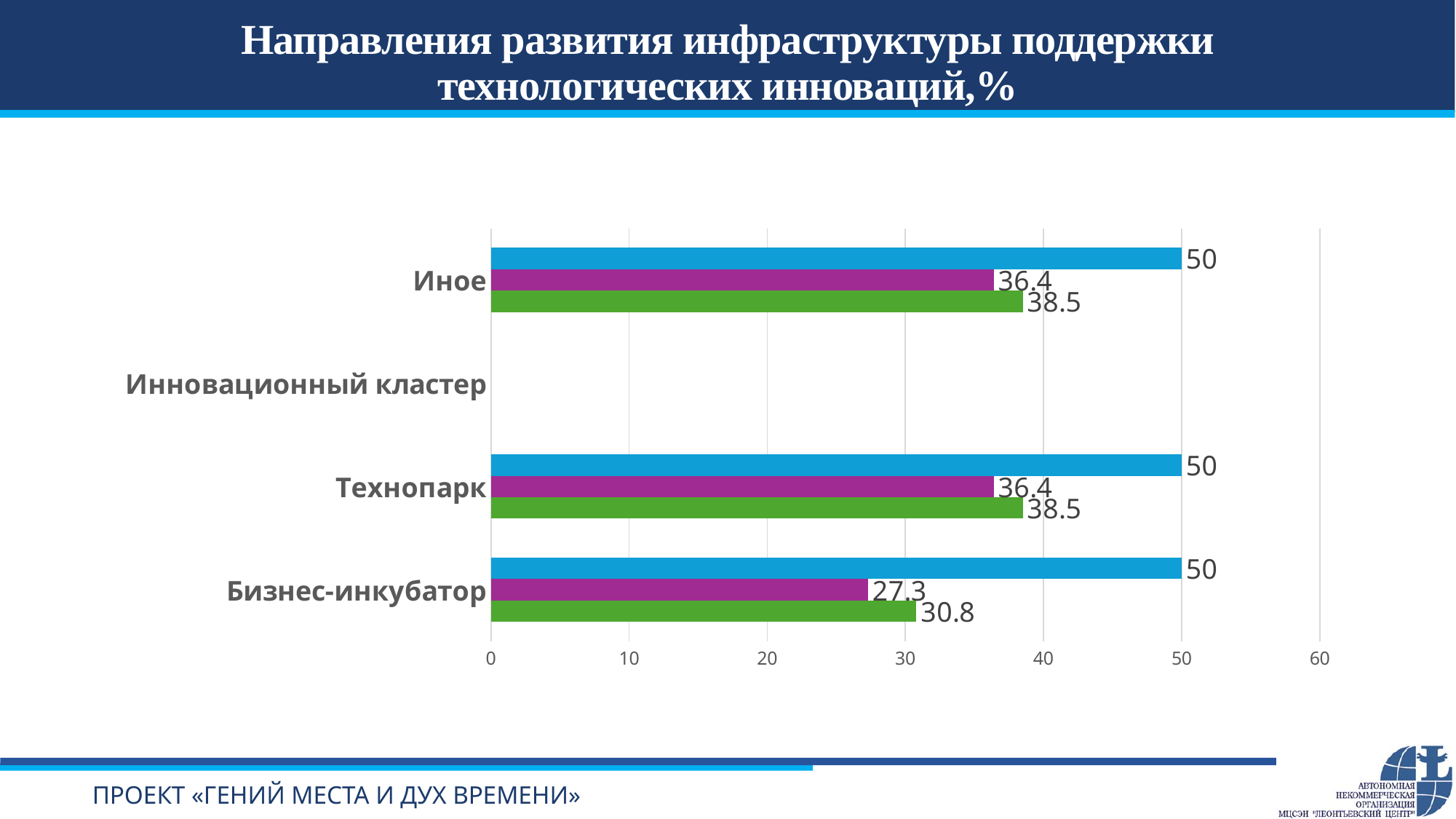
What is the difference between the blue bar and the purple bar for Бизнес-инкубатор? 22.7 How many categories are listed on the vertical axis of the chart? 4 What is the value of the green bar for Иное? 38.5 Which category has the lowest value for the purple bars? Бизнес-инкубатор Which category on the chart has no bars plotted? Инновационный кластер What is the value of the purple bar for Бизнес-инкубатор? 27.3 Which is larger for Технопарк, the green bar or the purple bar? the green bar What is the value of the blue bar for Технопарк? 50 What is the difference between the green bar and the purple bar for Технопарк? 2.1 What is the value of the purple bar for Иное? 36.4 What is the value of the green bar for Бизнес-инкубатор? 30.8 What type of chart is shown on the slide? bar chart